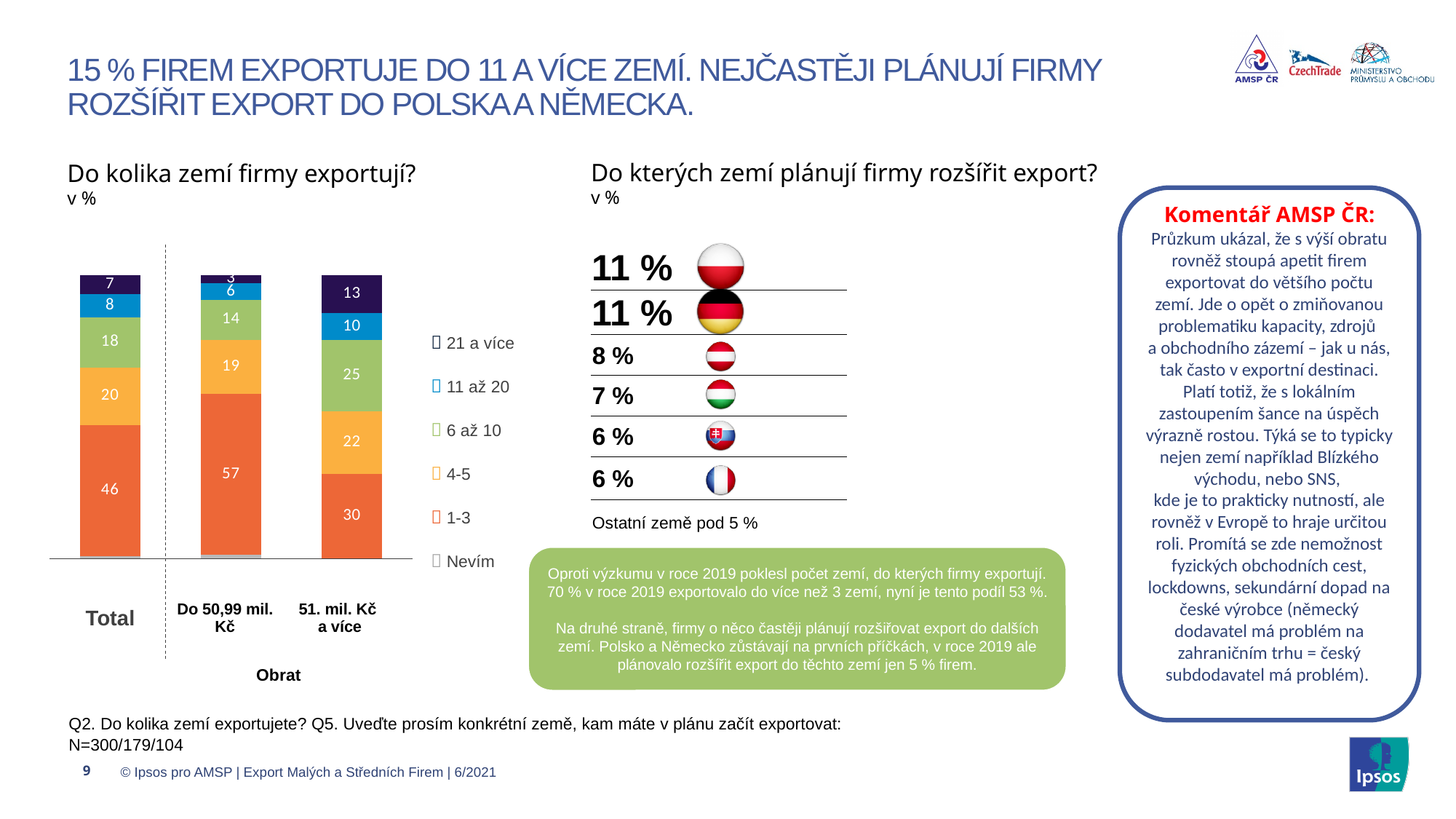
In the chart 'Do kolika zemí firmy exportují?', what is the value of the '11 až 20' segment for Total? 8 In the chart 'Do kolika zemí firmy exportují?', what is the value of the '1-3' segment for Total? 46 In the chart 'Do kolika zemí firmy exportují?', what is the difference between the '21 a více' values for '51. mil. Kč a více' and 'Do 50,99 mil. Kč'? 10 How many series does the legend of the chart 'Do kolika zemí firmy exportují?' list? 6 In the chart 'Do kolika zemí firmy exportují?', what is the value of the '6 až 10' segment for 'Do 50,99 mil. Kč'? 14 How many bars are shown in the chart 'Do kolika zemí firmy exportují?'? 3 In the chart 'Do kolika zemí firmy exportují?', what is the difference between the '1-3' values for Total and '51. mil. Kč a více'? 16 What kind of chart is 'Do kolika zemí firmy exportují?'? Stacked bar chart In the chart 'Do kolika zemí firmy exportují?', which bar has the largest '1-3' segment? Do 50,99 mil. Kč In the chart 'Do kolika zemí firmy exportují?', which bar has the larger '4-5' segment: 'Do 50,99 mil. Kč' or '51. mil. Kč a více'? 51. mil. Kč a více What is the axis label under the two right-hand bars of the chart 'Do kolika zemí firmy exportují?'? Obrat In the chart 'Do kolika zemí firmy exportují?', what is the value of the '21 a více' segment for '51. mil. Kč a více'? 13